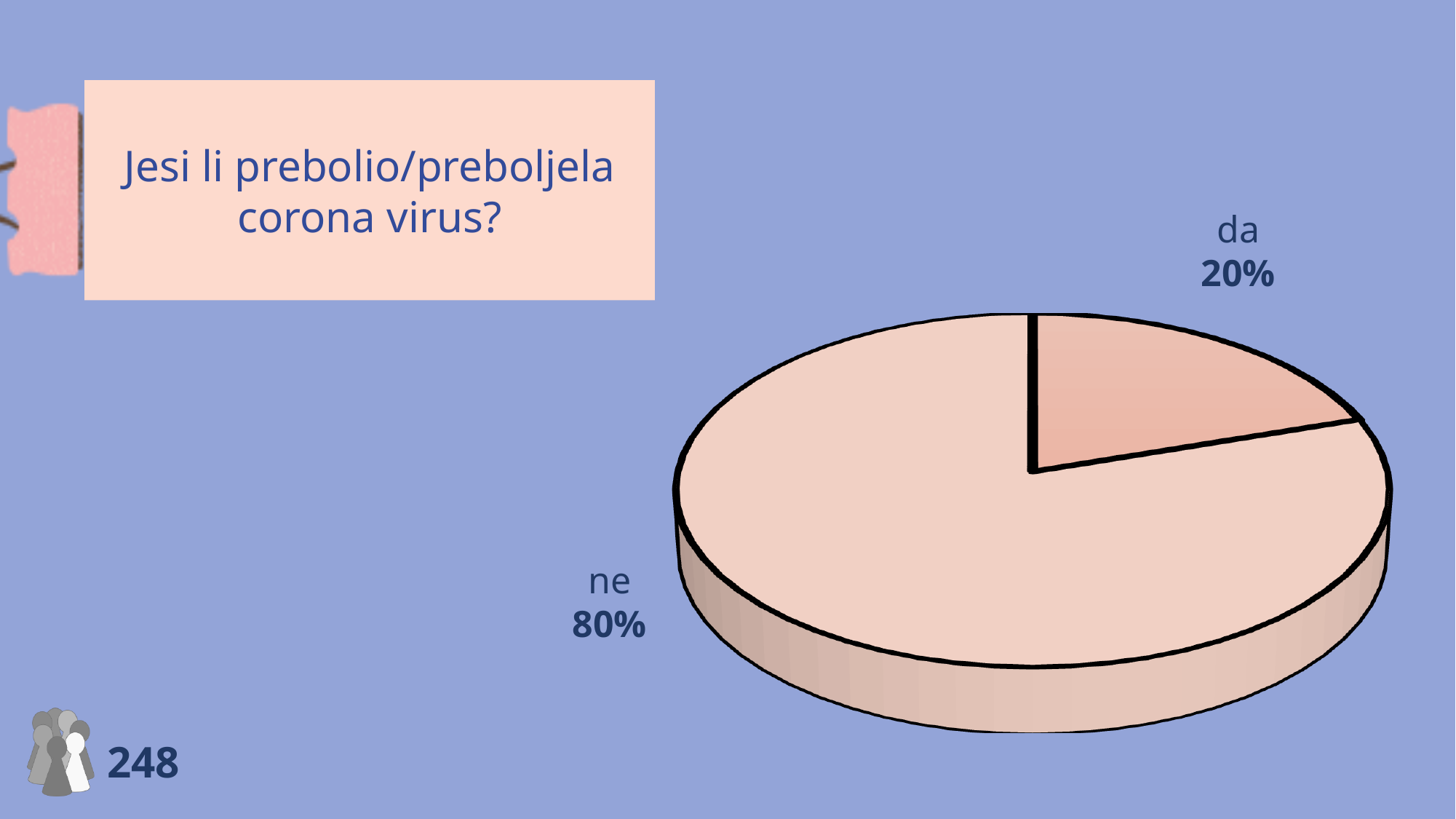
Which is larger, the "da" slice or the "ne" slice? ne Which slice of the pie is the smallest? da Which slice of the pie is the largest? ne What question is the chart answering, as shown in the title box? Jesi li prebolio/preboljela corona virus? What share of the pie does the "da" slice represent? 20% How many slices does the pie chart have? 2 What share of the pie does the "ne" slice represent? 80% What is the difference in percentage points between the "ne" and "da" slices? 60% What kind of chart is shown on the slide? pie chart What is the total of the two slices shown in the pie chart? 100% What number is shown next to the people icon at the bottom left of the slide? 248